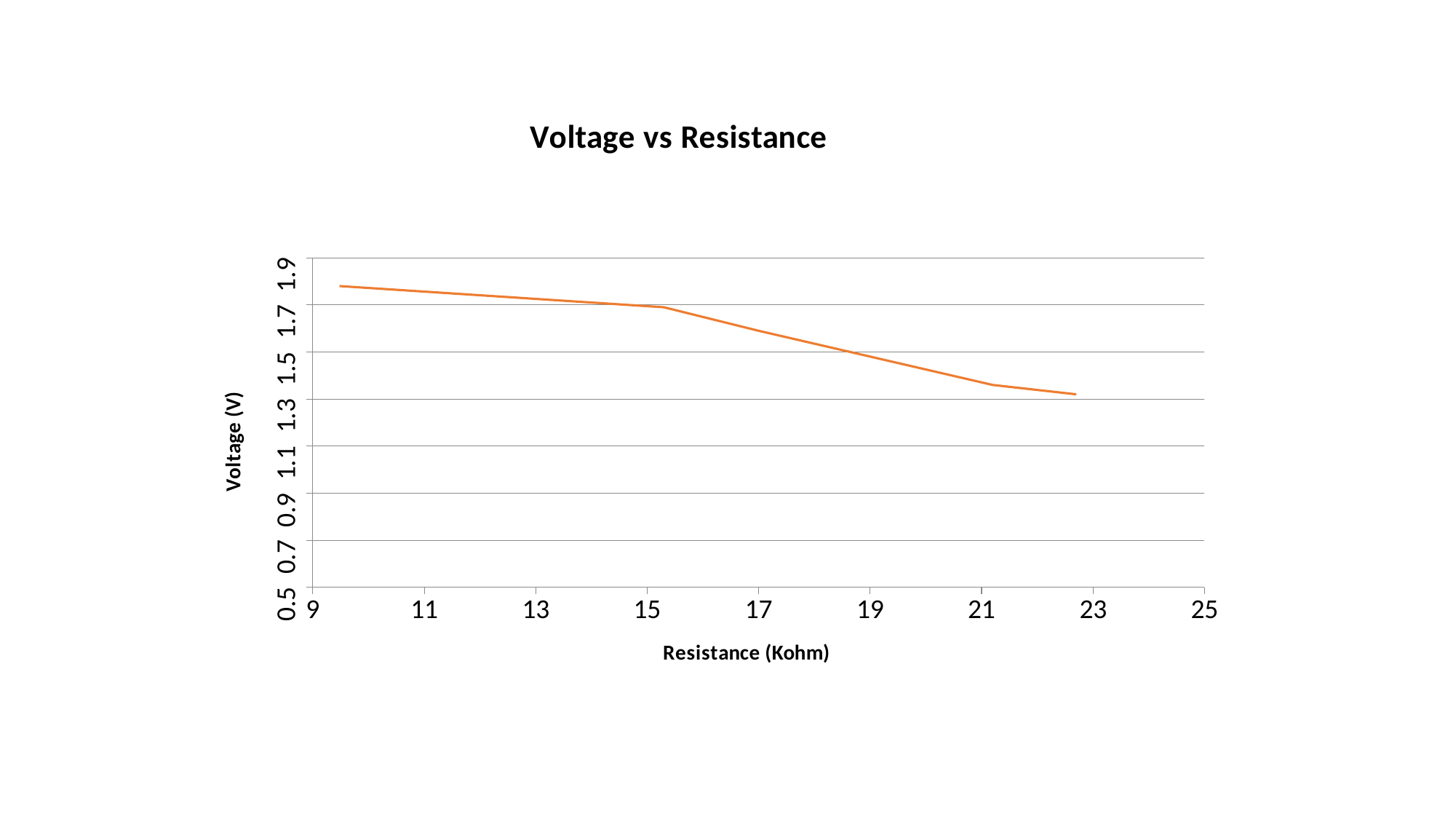
What is the title of the chart? Voltage vs Resistance Is the voltage at a resistance of 13 Kohm greater or less than 1.5 V? greater At which end of the resistance range is the voltage highest, the low-resistance end or the high-resistance end? The low-resistance end Is the voltage at the rightmost point of the line (around 23 Kohm) greater or less than 1.5 V? less What kind of chart is shown on the slide? Line chart Is the voltage at a resistance of 17 Kohm greater or less than 1.7 V? less Which is larger: the voltage at 11 Kohm or the voltage at 21 Kohm? The voltage at 11 Kohm As resistance increases along the x axis, does the voltage rise or fall? Fall What is the label of the x axis? Resistance (Kohm)